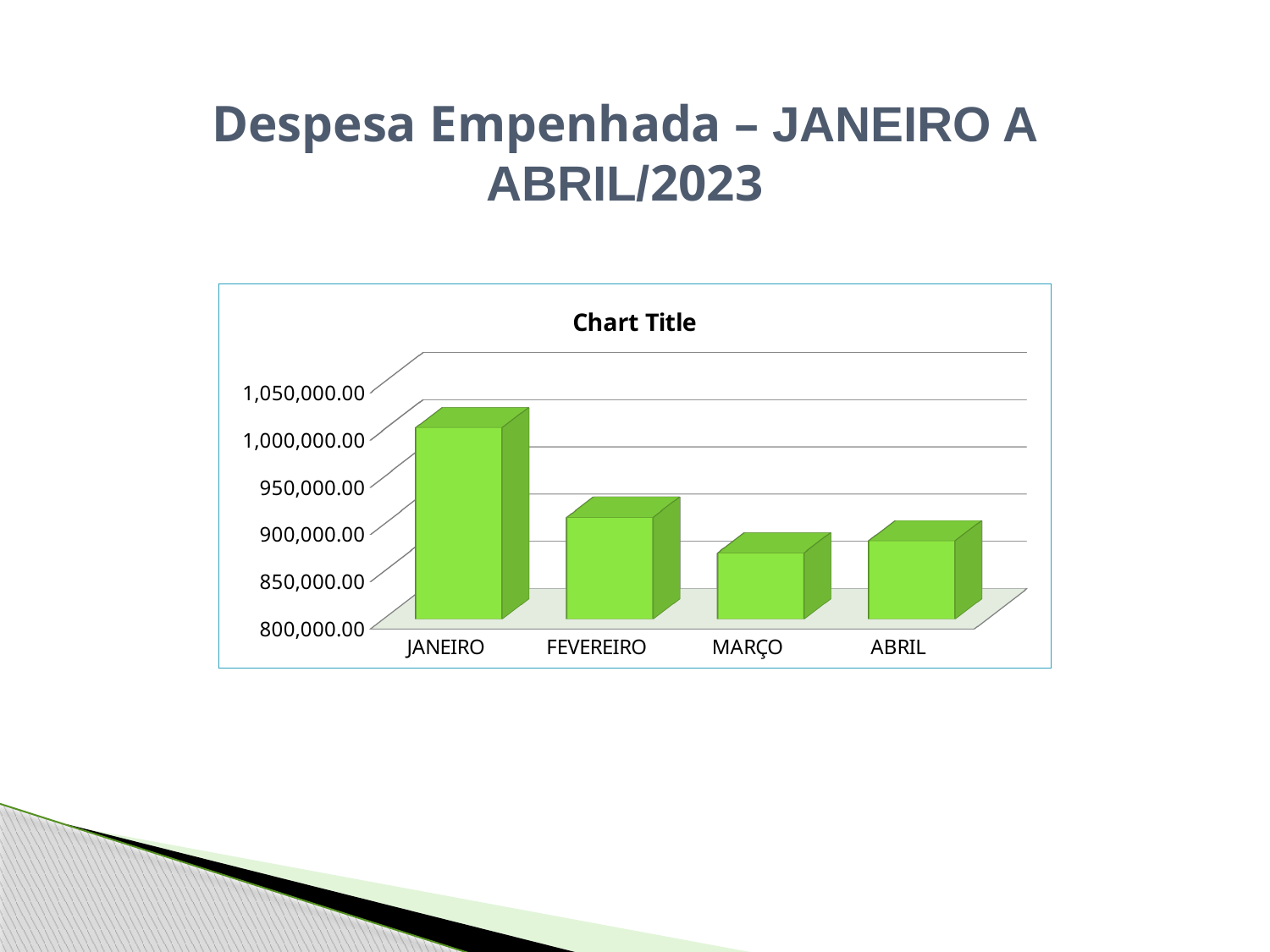
What title is printed above the chart's plot area? Chart Title Do the values rise or fall from JANEIRO to MARÇO? fall What kind of chart is shown on the slide? Bar chart How many categories (months) are shown on the x axis of the chart? 4 Which month has the lowest value in the chart? MARÇO Is the value for ABRIL greater or less than 850,000.00? greater Is the value for FEVEREIRO greater or less than 950,000.00? less Is the value for MARÇO greater or less than 850,000.00? greater Which is larger, the value for JANEIRO or the value for FEVEREIRO? JANEIRO Which is larger, the value for FEVEREIRO or the value for ABRIL? FEVEREIRO Which month has the highest value in the chart? JANEIRO